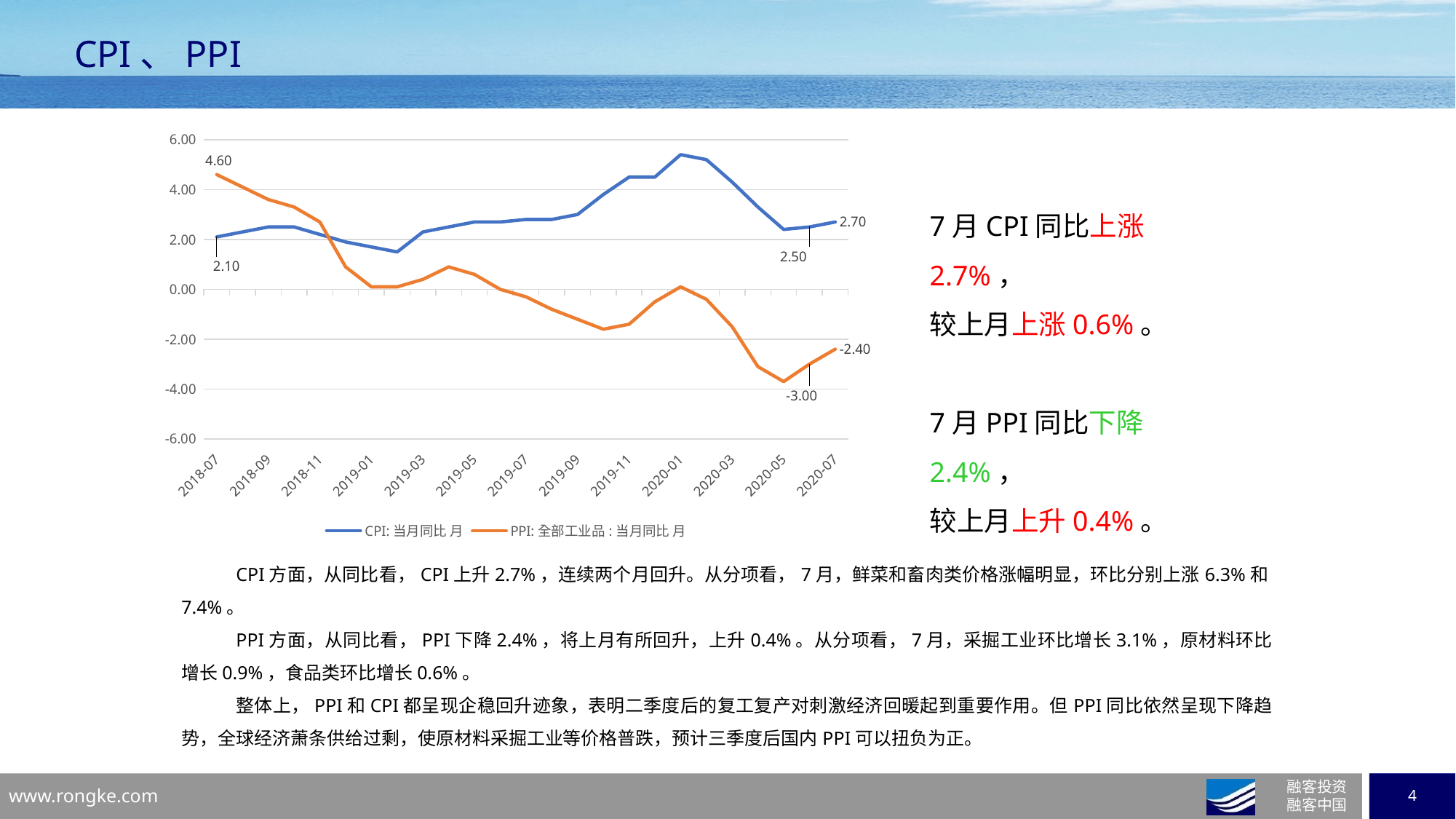
What is the difference between the CPI and PPI values at 2020-07? 5.10 Does the PPI series overall rise or fall from 2018-07 to 2020-07? Fall What is the PPI value at 2018-07? 4.60 Is the CPI value at 2020-01 greater or less than 4.00? greater What is the CPI value at 2018-07? 2.10 What is the CPI value at 2020-07? 2.70 Is the PPI value at 2020-05 greater or less than -2.00? less What kind of chart is shown on the slide? Line chart At 2018-07, which series has the higher value, CPI or PPI? PPI What is the PPI value at 2020-07? -2.40 By how much did the CPI value change from 2018-07 to 2020-07? 0.60 How many series does the legend list? 2